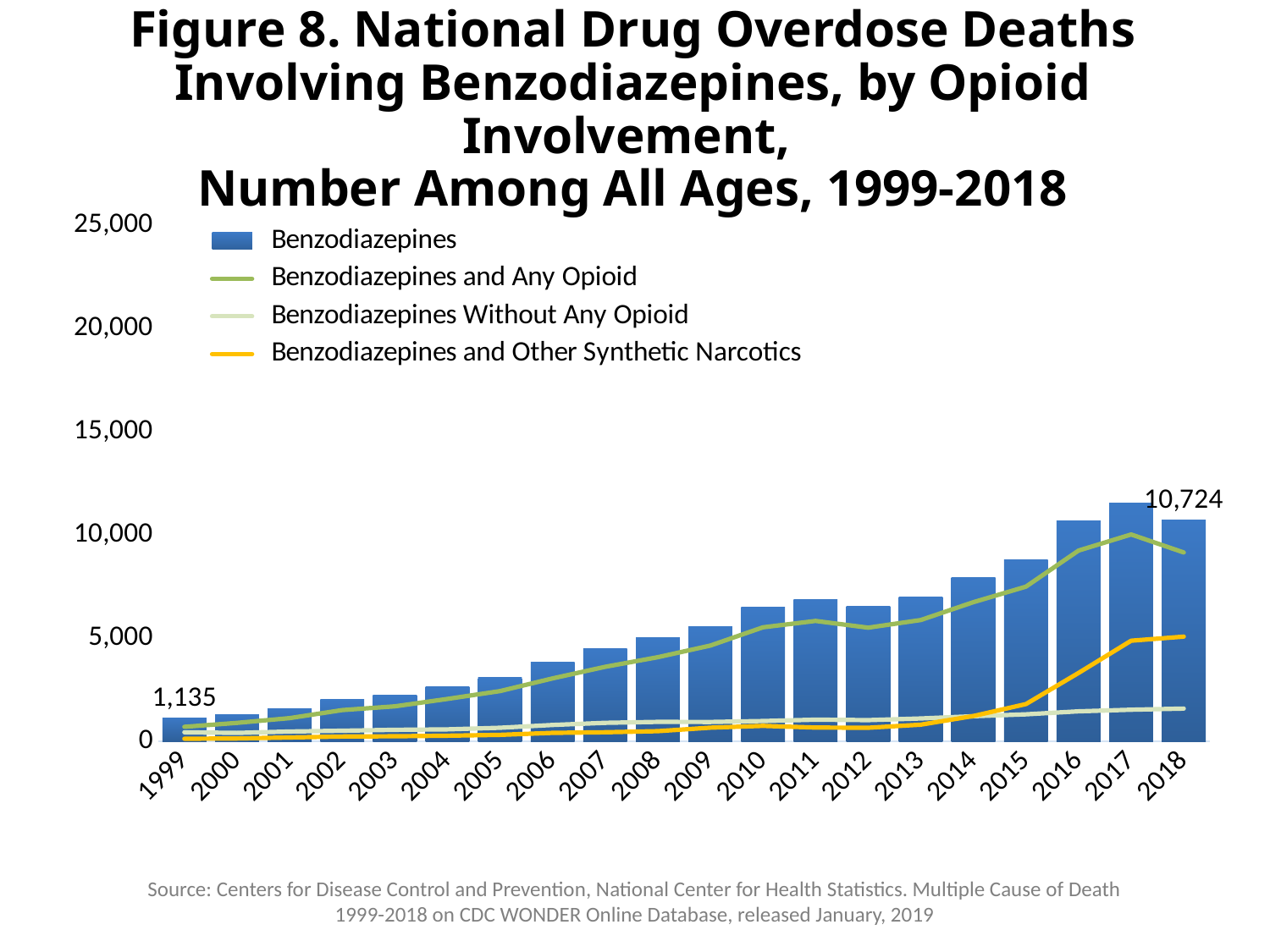
In 2018, which is larger: Benzodiazepines and Any Opioid or Benzodiazepines Without Any Opioid? Benzodiazepines and Any Opioid Which year has the highest Benzodiazepines bar? 2017 What kind of chart is this? Bar chart with line series How many series does the legend list? 4 Is the Benzodiazepines value for 2010 greater or less than 5,000? greater Which year has the lowest Benzodiazepines bar? 1999 Which series is plotted as bars rather than a line? Benzodiazepines How many years are shown on the x axis? 20 What is the difference between the Benzodiazepines values for 2018 and 1999? 9,589 Do the Benzodiazepines bars generally rise or fall from 1999 to 2017? Rise What is the value of the Benzodiazepines bar for 1999? 1,135 What is the value of the Benzodiazepines bar for 2018? 10,724